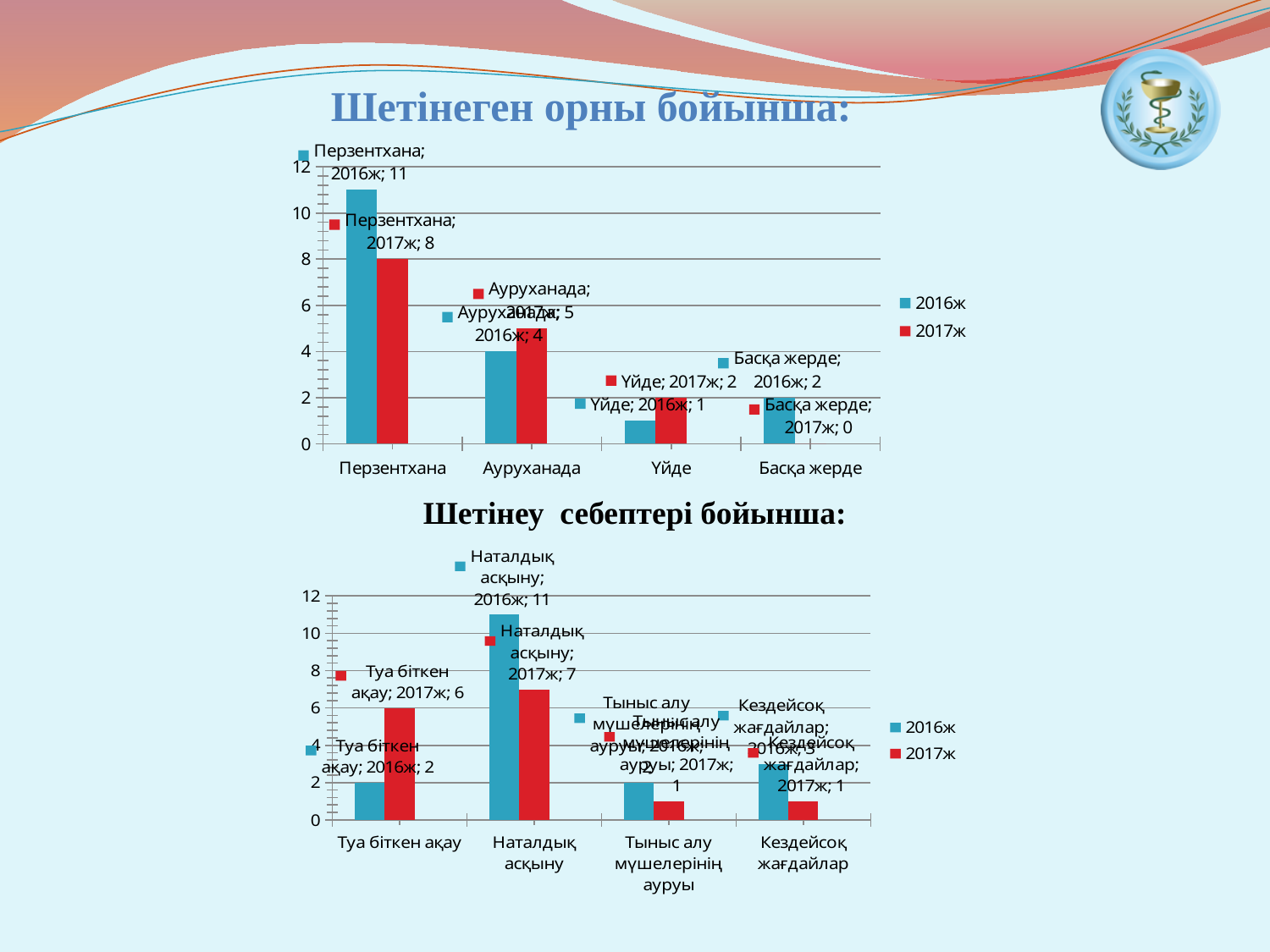
In the top chart (Шетінеген орны бойынша), how many series does the legend list? 2 What kind of chart is the top chart (Шетінеген орны бойынша)? Bar chart In the bottom chart (Шетінеу себептері бойынша), which is larger for Туа біткен ақау: the 2016ж value or the 2017ж value? 2017ж In the top chart (Шетінеген орны бойынша), which category has the highest value for 2016ж? Перзентхана In the bottom chart (Шетінеу себептері бойынша), what is the value for Туа біткен ақау in 2016ж? 2 In the top chart (Шетінеген орны бойынша), what is the value for Перзентхана in 2016ж? 11 In the top chart (Шетінеген орны бойынша), which category has the lowest value for 2017ж? Басқа жерде How many categories are shown on the x axis of the bottom chart (Шетінеу себептері бойынша)? 4 In the bottom chart (Шетінеу себептері бойынша), which category has the highest value for 2016ж? Наталдық асқыну In the bottom chart (Шетінеу себептері бойынша), what is the value for Наталдық асқыну in 2017ж? 7 In the top chart (Шетінеген орны бойынша), what is the difference between the 2016ж and 2017ж values for Перзентхана? 3 In the top chart (Шетінеген орны бойынша), what is the value for Ауруханада in 2017ж? 5